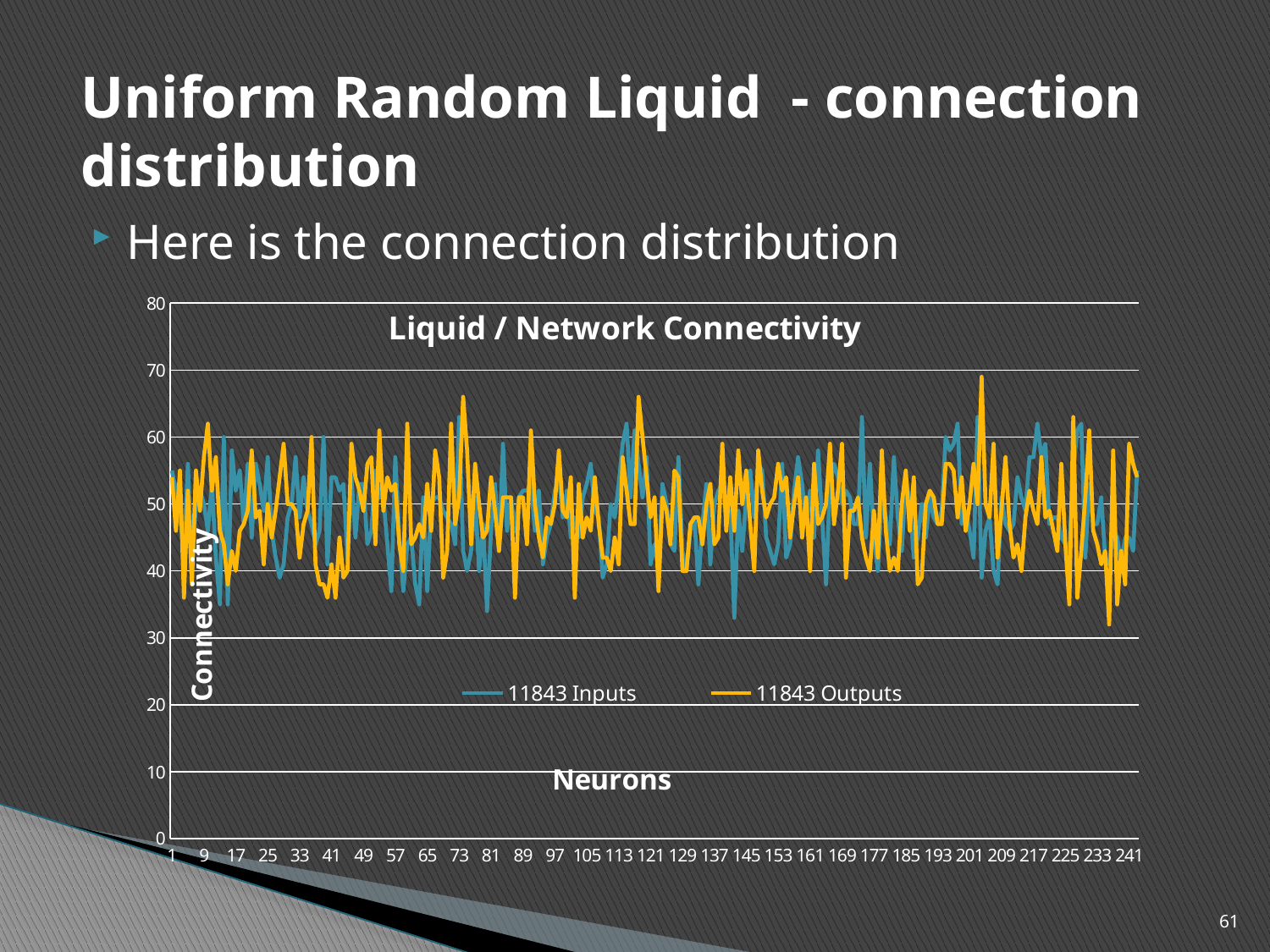
Is the lowest value of the 11843 Inputs series greater or less than 40? less Is the lowest value of the 11843 Outputs series greater or less than 40? less Is the highest value of the 11843 Inputs series greater or less than 70? less What is the label of the horizontal axis of the chart? Neurons What kind of chart is shown on the slide? line chart What is the label of the vertical axis of the chart? Connectivity How many series does the chart's legend list? 2 What is the title of the chart? Liquid / Network Connectivity What are the two series named in the chart's legend? 11843 Inputs and 11843 Outputs What is the last tick label on the horizontal axis of the chart? 241 What is the highest value shown on the vertical axis of the chart? 80